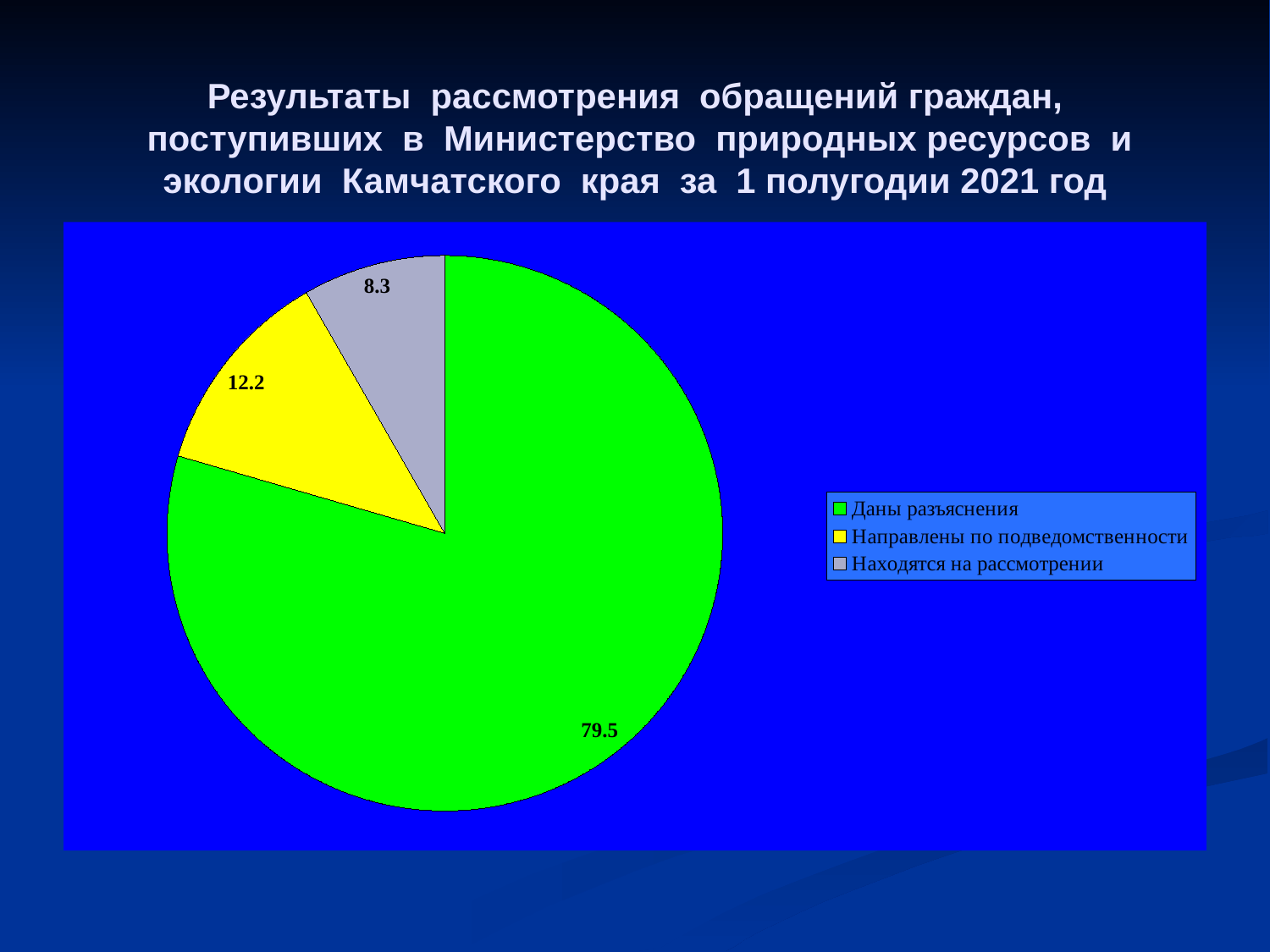
Which category has the largest slice? Даны разъяснения How many slices does the pie chart have? 3 What colour is the slice for "Даны разъяснения"? green What is the difference between the values for "Направлены по подведомственности" and "Находятся на рассмотрении"? 3.9 What colour is the slice for "Находятся на рассмотрении"? grey What is the value for "Находятся на рассмотрении"? 8.3 What is the value for "Даны разъяснения"? 79.5 What is the difference between the values for "Даны разъяснения" and "Направлены по подведомственности"? 67.3 Which is larger, the value for "Направлены по подведомственности" or for "Находятся на рассмотрении"? Направлены по подведомственности Which category has the smallest slice? Находятся на рассмотрении What is the value for "Направлены по подведомственности"? 12.2 What kind of chart is shown on the slide? pie chart